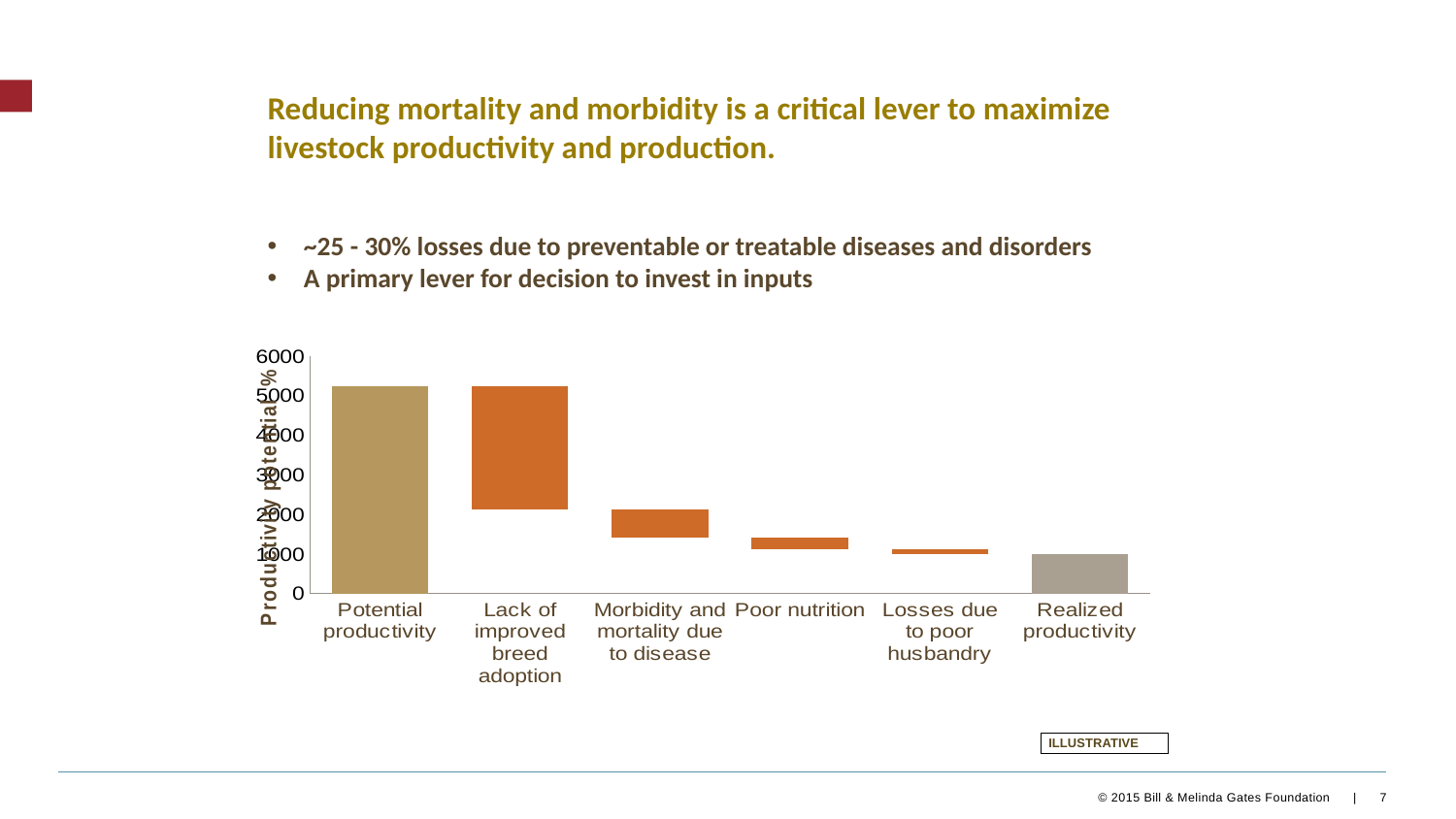
Which category has the tallest bar in the chart? Potential productivity Is the value for Potential productivity greater or less than 4000? greater Is the value for Realized productivity greater or less than 2000? less What colour is the Realized productivity bar? Grey Is the top of the Morbidity and mortality due to disease bar greater or less than 3000? less Which is larger, the bar for Potential productivity or the bar for Realized productivity? Potential productivity Do the bar tops rise or fall moving from left to right across the chart? fall What kind of chart is shown on the slide? Bar chart What is the label on the vertical axis of the chart? Productivity potential % How many categories are shown along the x axis of the chart? 6